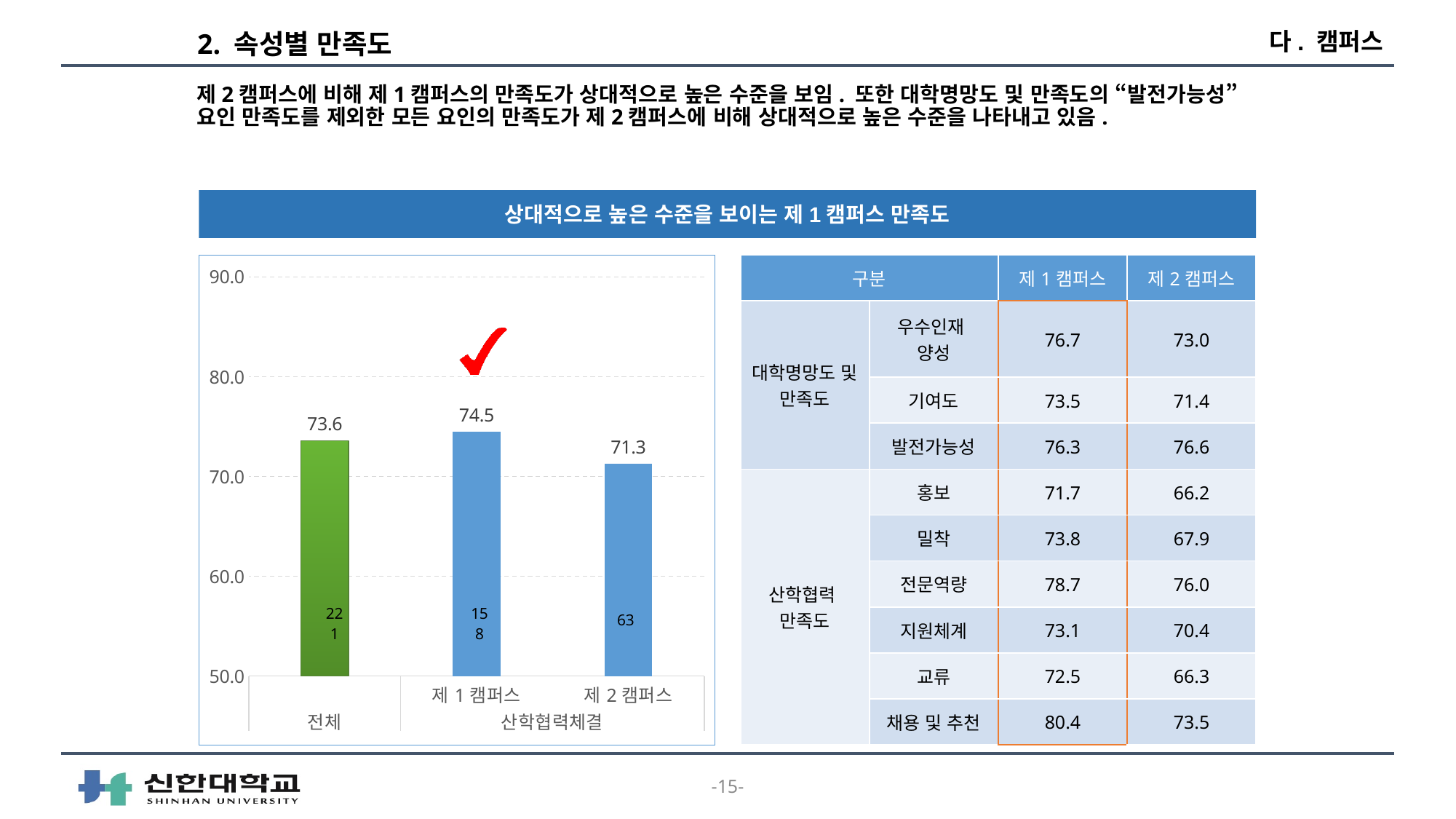
What is the difference between the values for 제 1 캠퍼스 and 제 2 캠퍼스 in the bar chart? 3.2 Which category has the highest value in the bar chart? 제 1 캠퍼스 What is the value shown for 전체 in the bar chart? 73.6 Which category has the lowest value in the bar chart? 제 2 캠퍼스 What is the value shown for 제 1 캠퍼스 in the bar chart? 74.5 Which is larger in the bar chart, the value for 전체 or the value for 제 2 캠퍼스? 전체 What is the value shown for 제 2 캠퍼스 in the bar chart? 71.3 How many bars are plotted in the bar chart? 3 What kind of chart is shown on the left of the slide? bar chart Is the value for 제 2 캠퍼스 in the bar chart greater or less than 80.0? less What colour is the bar for 전체 in the bar chart? green What is the difference between the values for 제 1 캠퍼스 and 전체 in the bar chart? 0.9